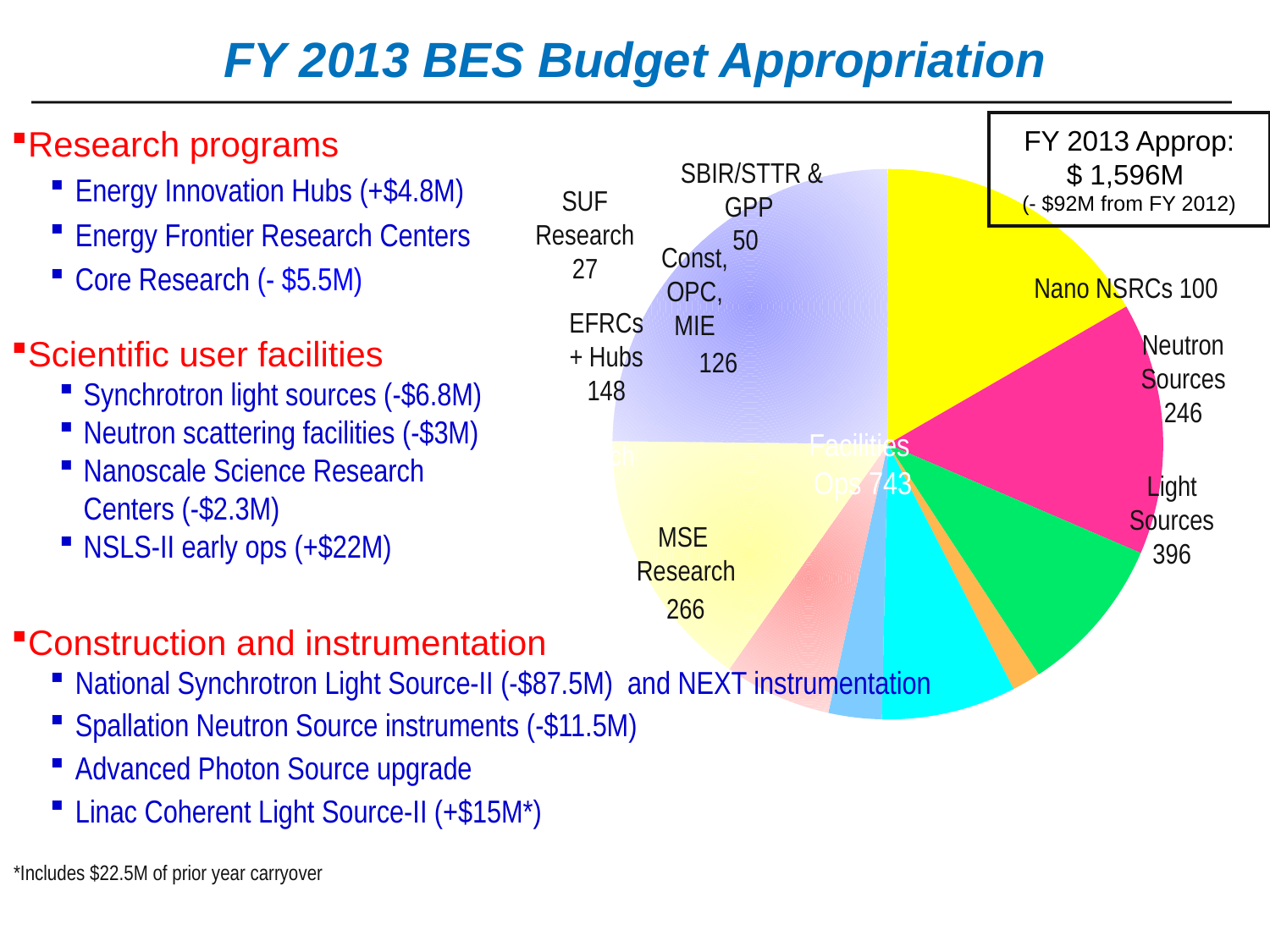
What value is shown for Neutron Sources in the pie chart? 246 What total FY 2013 appropriation is shown in the box next to the pie chart? $ 1,596M Which is larger in the pie chart, Light Sources or Neutron Sources? Light Sources What value is shown for EFRCs + Hubs in the pie chart? 148 What value is shown for Light Sources in the pie chart? 396 What kind of chart is shown on the slide? pie chart What value is shown for SUF Research in the pie chart? 27 What value is shown for MSE Research in the pie chart? 266 What value is shown for Const, OPC, MIE in the pie chart? 126 What is the difference between the Light Sources value and the Neutron Sources value in the pie chart? 150 What value is shown for Nano NSRCs in the pie chart? 100 Which has the smallest value in the pie chart? SUF Research